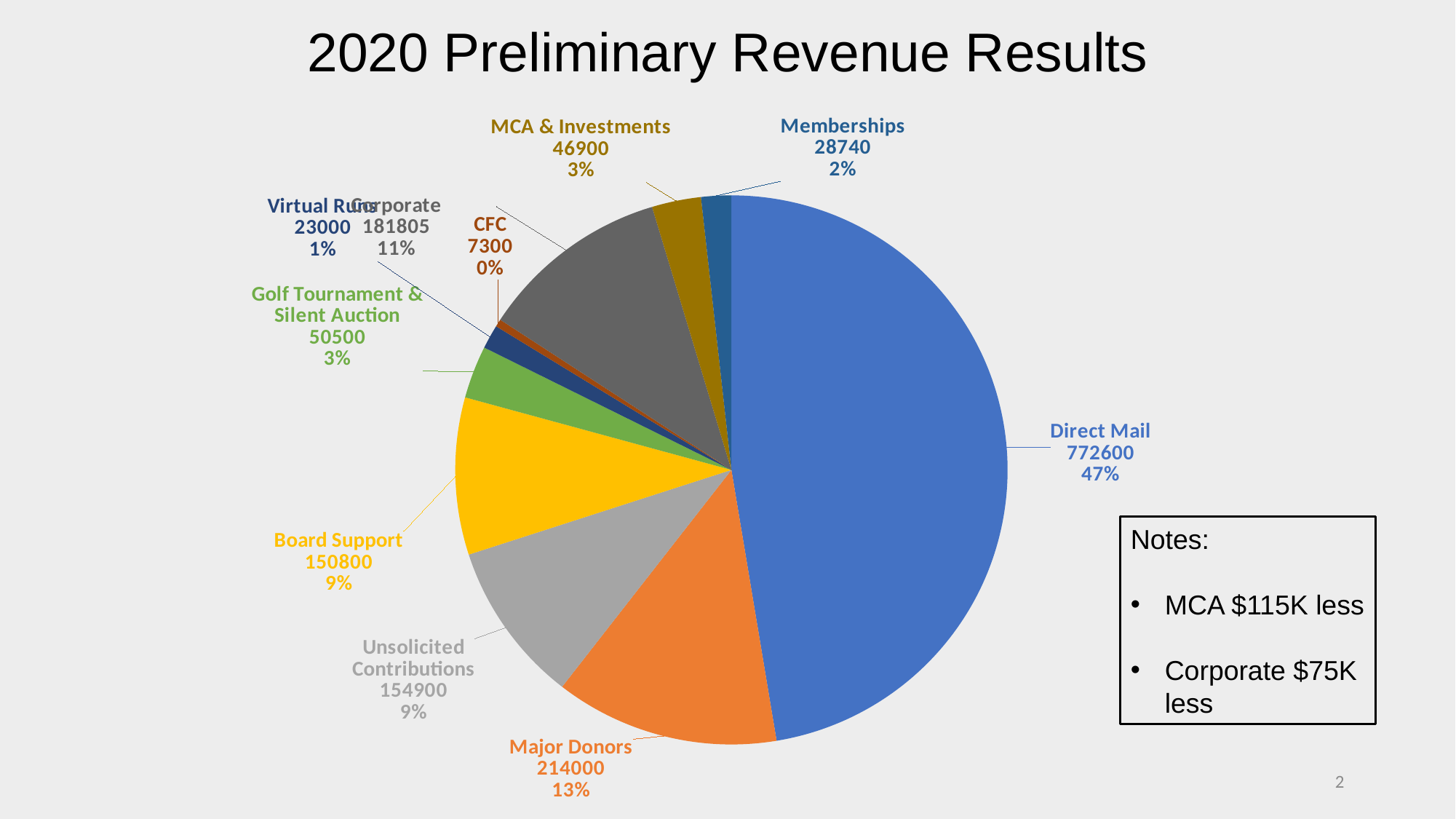
What is the revenue value for Direct Mail? 772600 What kind of chart is shown on the slide? pie chart Which category has the largest slice of the pie? Direct Mail How many categories are shown in the pie chart? 10 What is the difference between the Major Donors value and the Corporate value? 32195 What is the revenue value for Memberships? 28740 Which is larger, Unsolicited Contributions or Board Support? Unsolicited Contributions What share of the pie does Direct Mail represent? 47% What share of the pie does Corporate represent? 11% What is the title of the slide? 2020 Preliminary Revenue Results What is the revenue value for Major Donors? 214000 Which category has the smallest slice of the pie? CFC